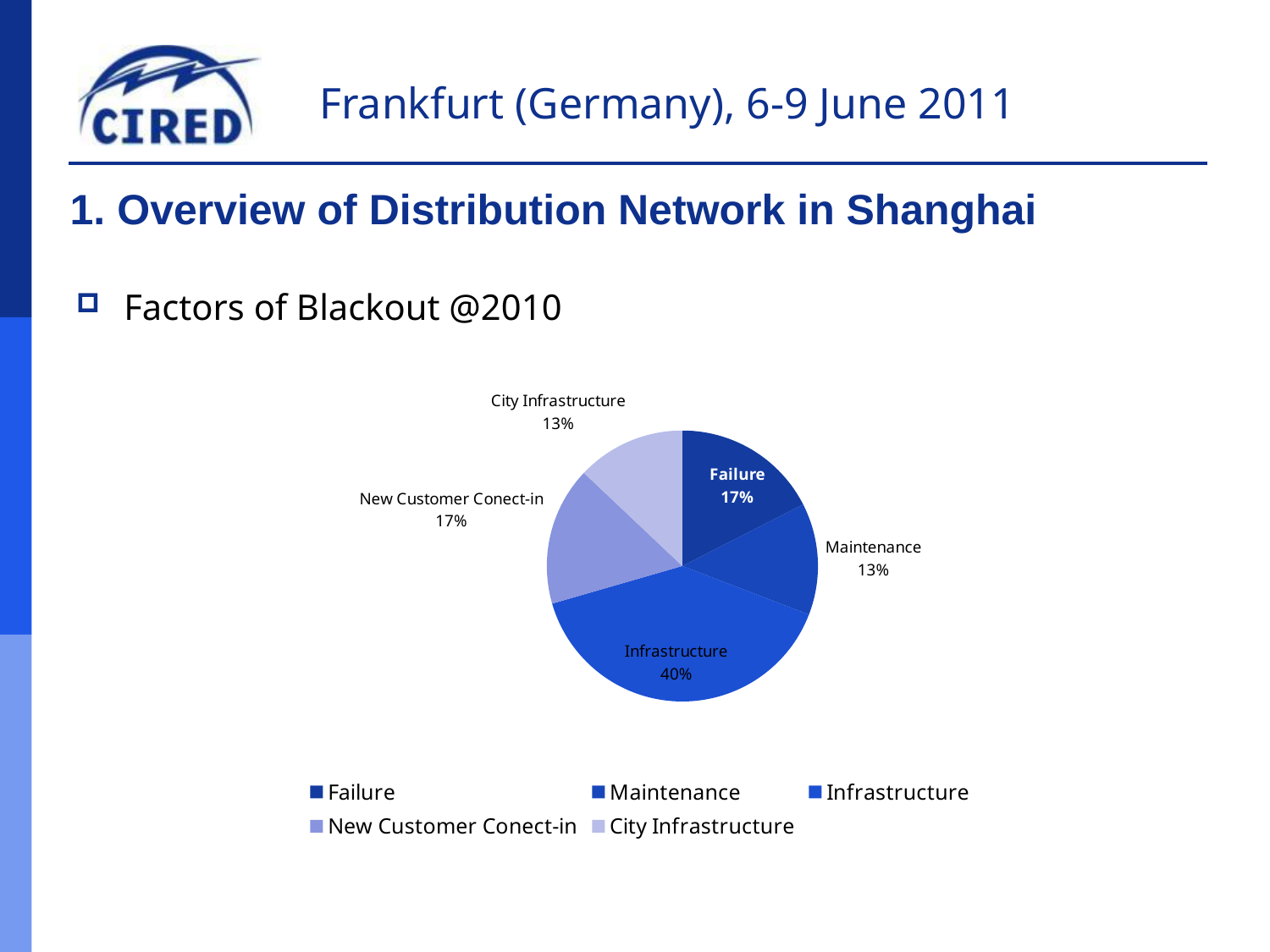
Which is larger, the share for Infrastructure or the share for Maintenance? Infrastructure What is the difference between the Infrastructure share and the Failure share? 23% What is the value shown for Maintenance? 13% What kind of chart is shown on the slide? Pie chart How many entries does the legend list? 5 What is the value shown for Failure? 17% What is the value shown for New Customer Conect-in? 17% What is the value shown for City Infrastructure? 13% Which category has the largest slice of the pie? Infrastructure What share of the pie does Infrastructure account for? 40% How many categories are shown in the pie chart? 5 What is the difference between the Failure share and the Maintenance share? 4%